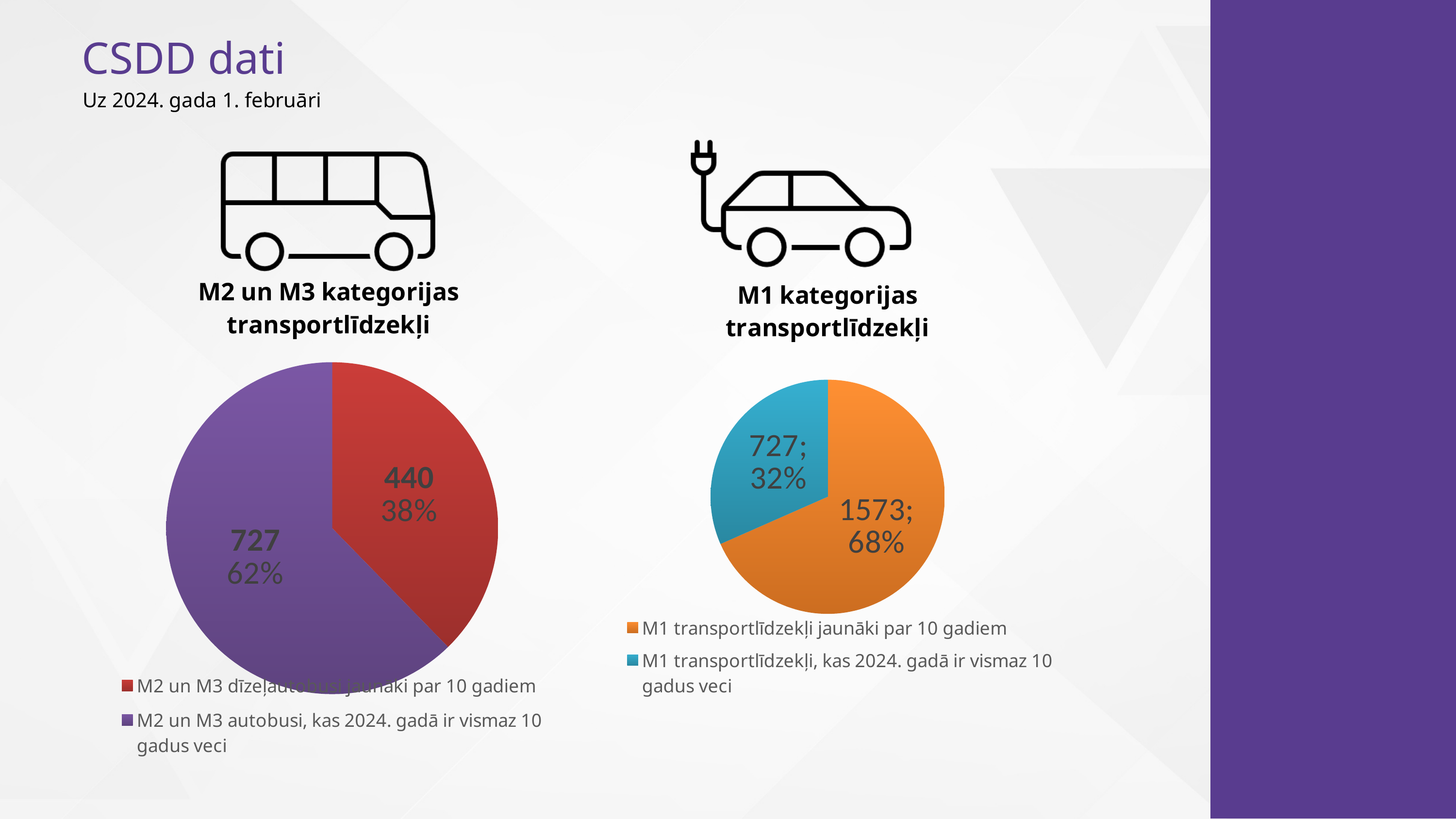
In the M1 kategorijas transportlīdzekļi chart, what colour is the slice for M1 transportlīdzekļi jaunāki par 10 gadiem? Orange In the M1 kategorijas transportlīdzekļi chart, what is the value for M1 transportlīdzekļi jaunāki par 10 gadiem? 1573 In the M1 kategorijas transportlīdzekļi chart, which category is the smallest? M1 transportlīdzekļi, kas 2024. gadā ir vismaz 10 gadus veci What type of chart is used for the M2 un M3 kategorijas transportlīdzekļi data? Pie chart In the M2 un M3 kategorijas transportlīdzekļi chart, which category is the largest? M2 un M3 autobusi, kas 2024. gadā ir vismaz 10 gadus veci In the M2 un M3 kategorijas transportlīdzekļi chart, what share of the pie is M2 un M3 dīzeļautobusi jaunāki par 10 gadiem? 38% In the M1 kategorijas transportlīdzekļi chart, what is the total of the two slice values? 2300 In the M2 un M3 kategorijas transportlīdzekļi chart, what is the value for M2 un M3 autobusi, kas 2024. gadā ir vismaz 10 gadus veci? 727 How many slices does the M1 kategorijas transportlīdzekļi pie chart have? 2 In the M2 un M3 kategorijas transportlīdzekļi chart, what is the difference between the two slice values? 287 In the M1 kategorijas transportlīdzekļi chart, what share of the pie is M1 transportlīdzekļi, kas 2024. gadā ir vismaz 10 gadus veci? 32% In the M2 un M3 kategorijas transportlīdzekļi chart, what is the value for M2 un M3 dīzeļautobusi jaunāki par 10 gadiem? 440